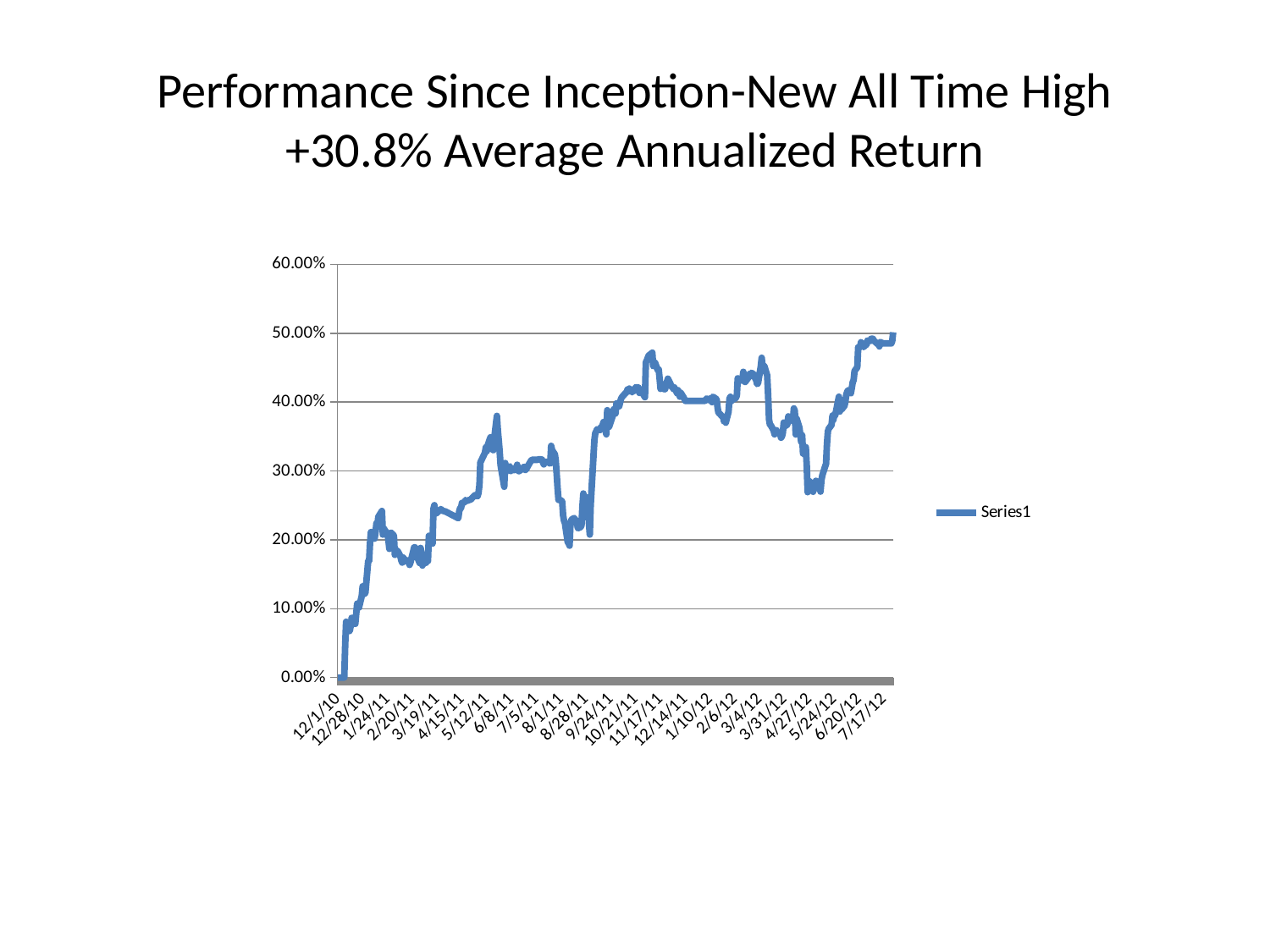
Is the value around 4/27/12 greater or less than 40.00%? less How many series does the legend list? 1 Is the value at the end of the line (7/17/12) greater or less than 40.00%? greater What value does the line start at on 12/1/10? 0.00% What is the name of the series shown in the legend? Series1 What is the title of the slide containing the chart? Performance Since Inception-New All Time High +30.8% Average Annualized Return What type of chart is shown on the slide? line chart Is the value around 12/28/10 greater or less than 20.00%? less Overall, does the line rise or fall from 12/1/10 to 7/17/12? rise